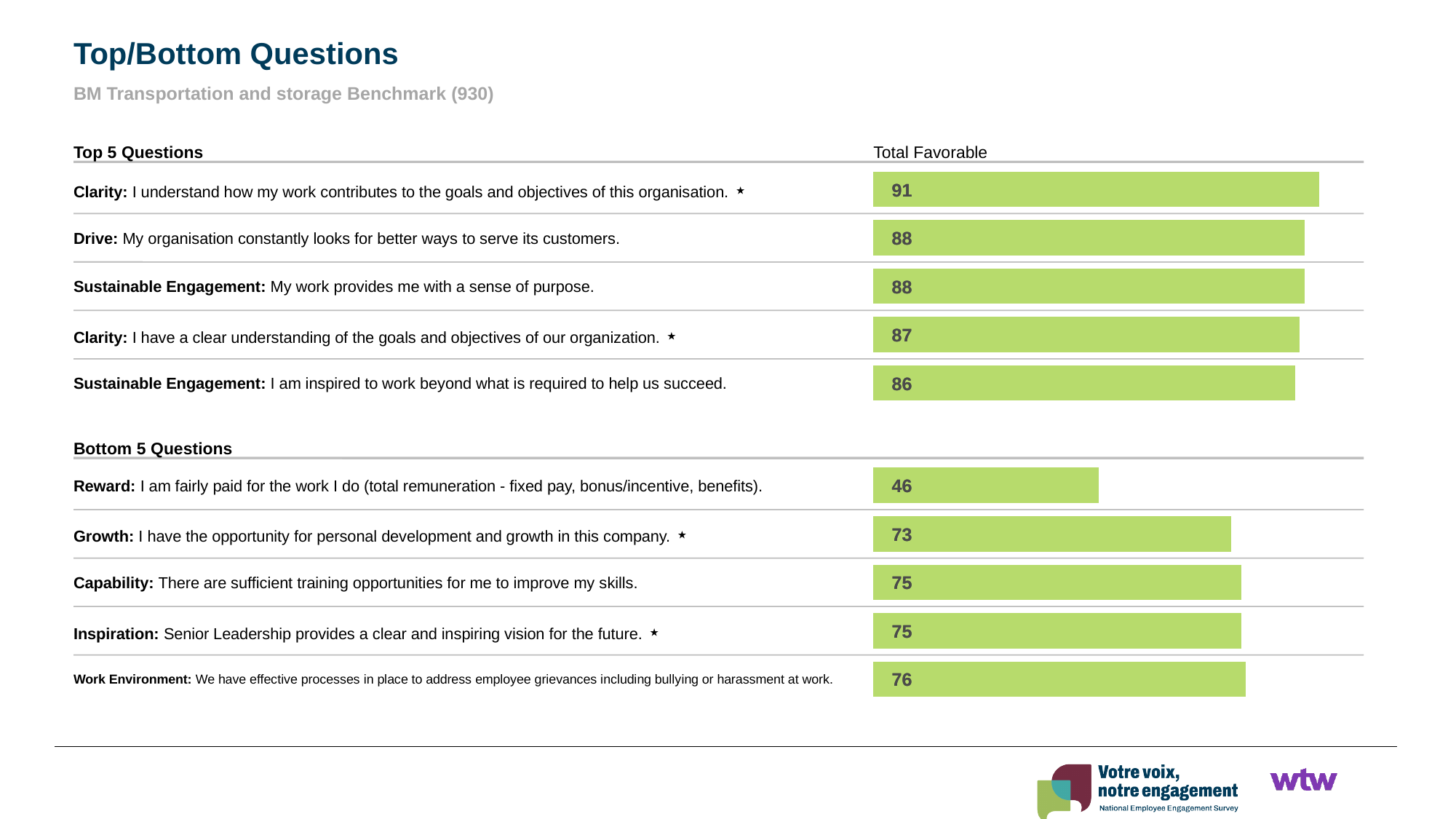
In the Top 5 Questions chart, what is the Total Favorable value for "Clarity: I understand how my work contributes to the goals and objectives of this organisation"? 91 How many questions are shown in the Bottom 5 Questions chart? 5 In the Bottom 5 Questions chart, what is the difference between the Work Environment value and the Reward value? 30 In the Bottom 5 Questions chart, which is larger: the value for Growth or the value for Work Environment? Work Environment In the Top 5 Questions chart, what is the Total Favorable value for "Drive: My organisation constantly looks for better ways to serve its customers"? 88 In the Bottom 5 Questions chart, what is the Total Favorable value for "Reward: I am fairly paid for the work I do"? 46 In the Top 5 Questions chart, which question has the highest Total Favorable value? Clarity: I understand how my work contributes to the goals and objectives of this organisation. In the Bottom 5 Questions chart, which question has the lowest Total Favorable value? Reward: I am fairly paid for the work I do (total remuneration - fixed pay, bonus/incentive, benefits). What is the subtitle shown under the slide title "Top/Bottom Questions"? BM Transportation and storage Benchmark (930) In the Bottom 5 Questions chart, what is the Total Favorable value for "Growth: I have the opportunity for personal development and growth in this company"? 73 What kind of chart is used to show the Total Favorable values on this slide? Bar chart In the Top 5 Questions chart, what is the difference between the highest value (91) and the lowest value (86)? 5